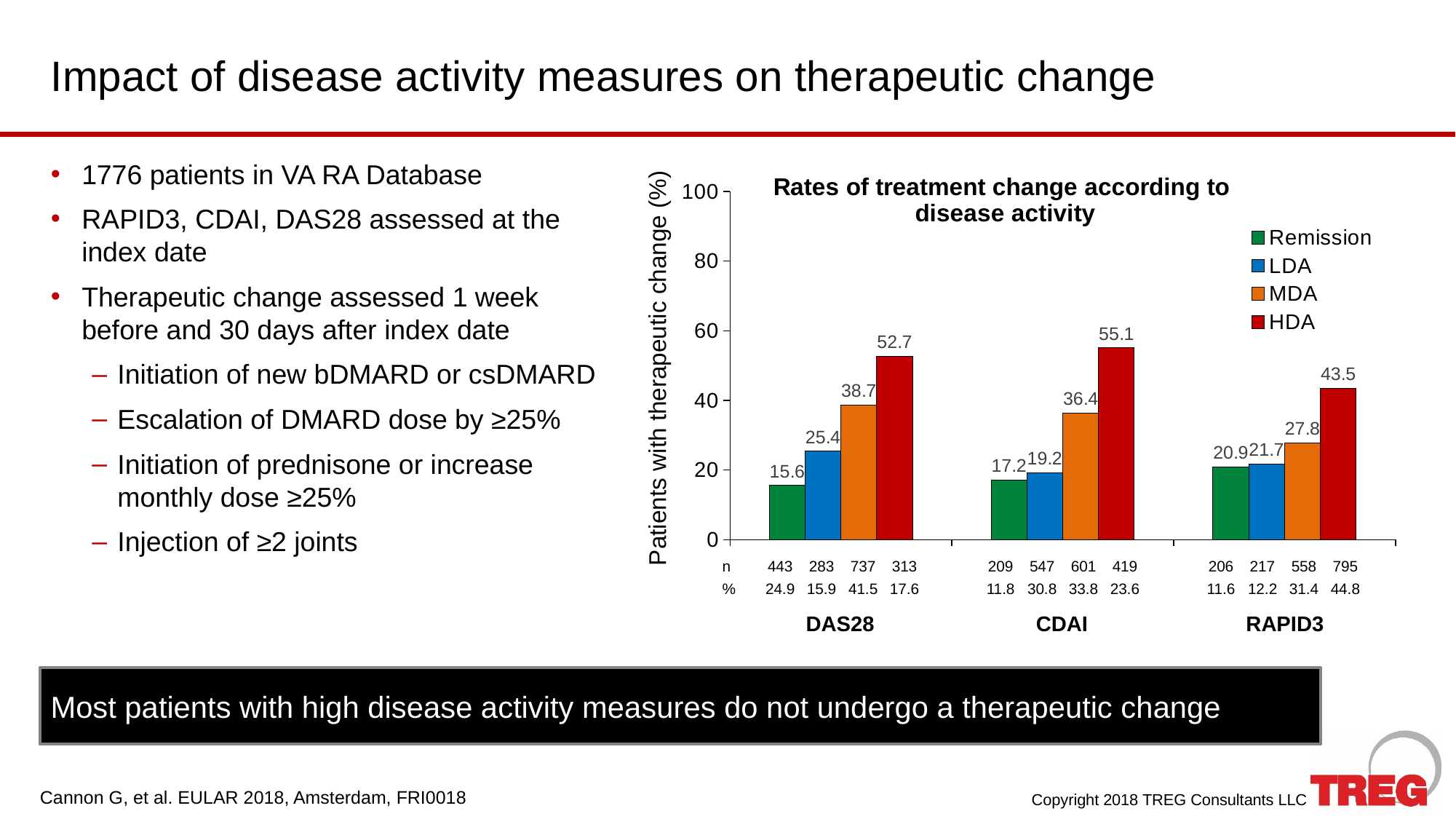
What is the value for MDA in the RAPID3 group? 27.8 Which series has the lowest value in the DAS28 group? Remission Which disease activity measure has the highest HDA value? CDAI Which is larger, the LDA value for DAS28 or the LDA value for RAPID3? DAS28 What kind of chart is shown on the slide? Bar chart What is the title of the chart? Rates of treatment change according to disease activity What is the value for HDA in the DAS28 group? 52.7 How many disease activity measures are shown on the x axis? 3 What is the difference between the HDA and Remission values in the CDAI group? 37.9 How many series does the legend list? 4 What is the value for Remission in the CDAI group? 17.2 Is the HDA value for RAPID3 greater or less than 40? greater